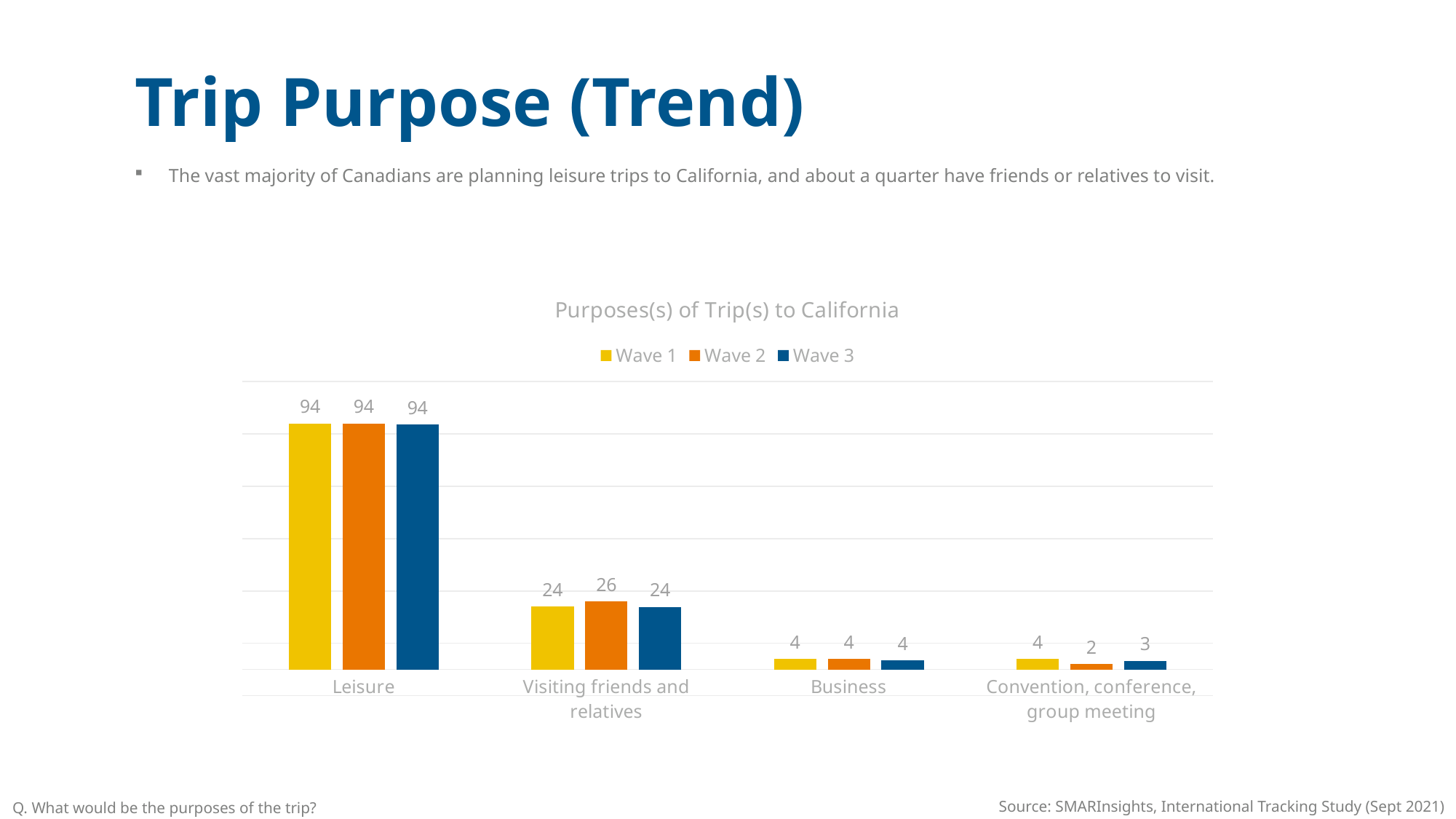
How many categories are shown on the x axis? 4 What is the difference between the Wave 1 value for Leisure and the Wave 1 value for Visiting friends and relatives? 70 What is the Wave 2 value for Convention, conference, group meeting? 2 Which category has the highest values across all waves? Leisure Which is larger: the Wave 1 value for Business or the Wave 2 value for Convention, conference, group meeting? Wave 1 value for Business What is the difference between the Wave 2 and Wave 3 values for Visiting friends and relatives? 2 What is the Wave 2 value for Visiting friends and relatives? 26 What is the Wave 1 value for Leisure? 94 How many series does the legend list? 3 What is the Wave 3 value for Convention, conference, group meeting? 3 What kind of chart is shown on the slide? Bar chart Which category has the lowest Wave 2 value? Convention, conference, group meeting